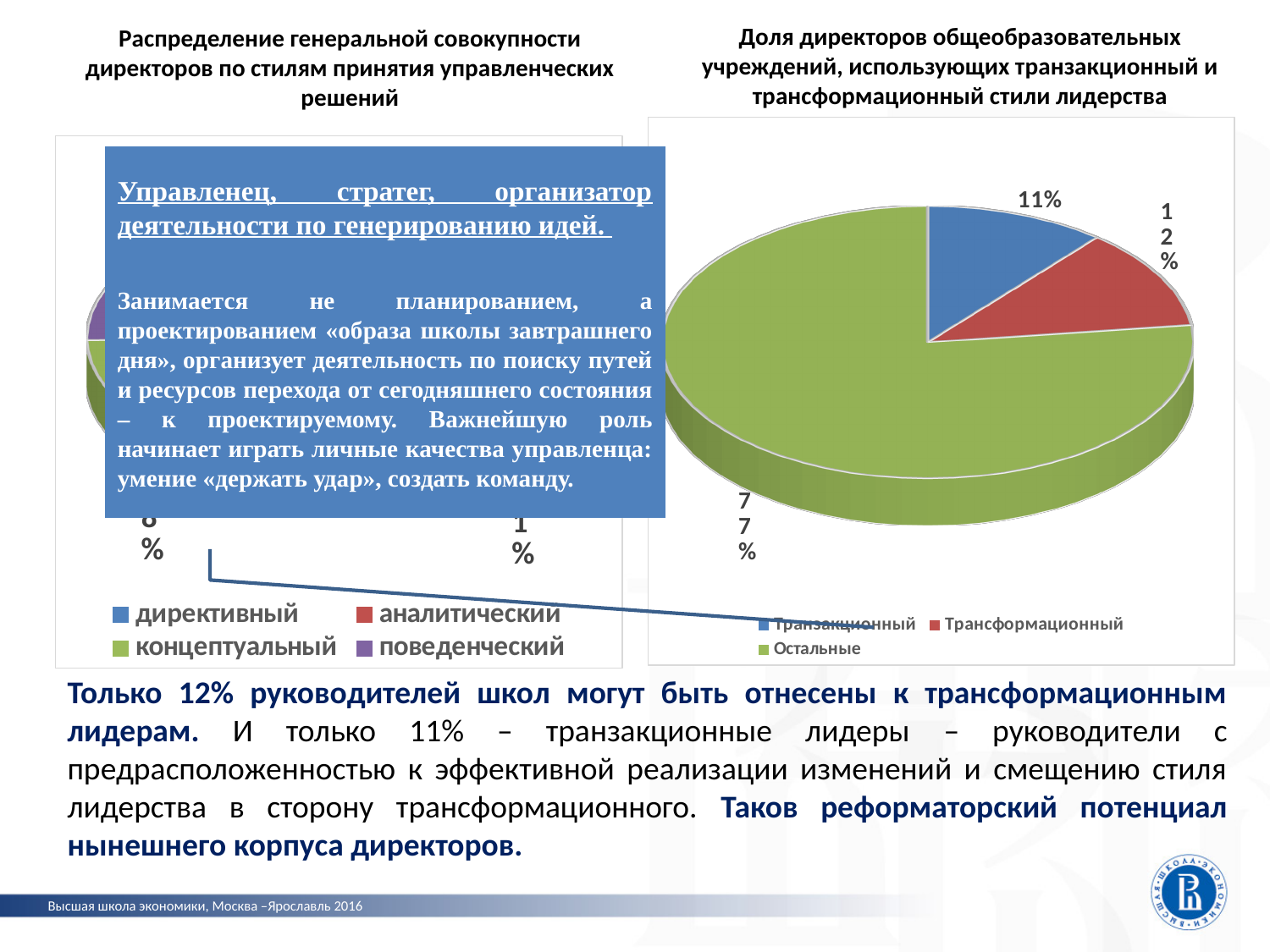
In the right chart (Доля директоров общеобразовательных учреждений...), what percentage is shown for Транзакционный? 11% In the right chart (Доля директоров общеобразовательных учреждений...), which category has the largest slice? Остальные How many slices does the right chart (Доля директоров общеобразовательных учреждений...) have? 3 In the right chart (Доля директоров общеобразовательных учреждений...), which is larger: Транзакционный or Трансформационный? Трансформационный In the right chart (Доля директоров общеобразовательных учреждений...), what percentage is shown for Остальные? 77% How many entries does the legend of the left chart (Распределение генеральной совокупности директоров...) list? 4 In the right chart (Доля директоров общеобразовательных учреждений...), what percentage is shown for Трансформационный? 12% What kind of chart is the left chart (Распределение генеральной совокупности директоров...)? Pie chart In the right chart (Доля директоров общеобразовательных учреждений...), which category has the smallest slice? Транзакционный What kind of chart is the right chart (Доля директоров общеобразовательных учреждений...)? Pie chart In the right chart (Доля директоров общеобразовательных учреждений...), what is the combined share of Транзакционный and Трансформационный? 23% In the right chart (Доля директоров общеобразовательных учреждений...), what is the difference in percentage points between Остальные and Трансформационный? 65%